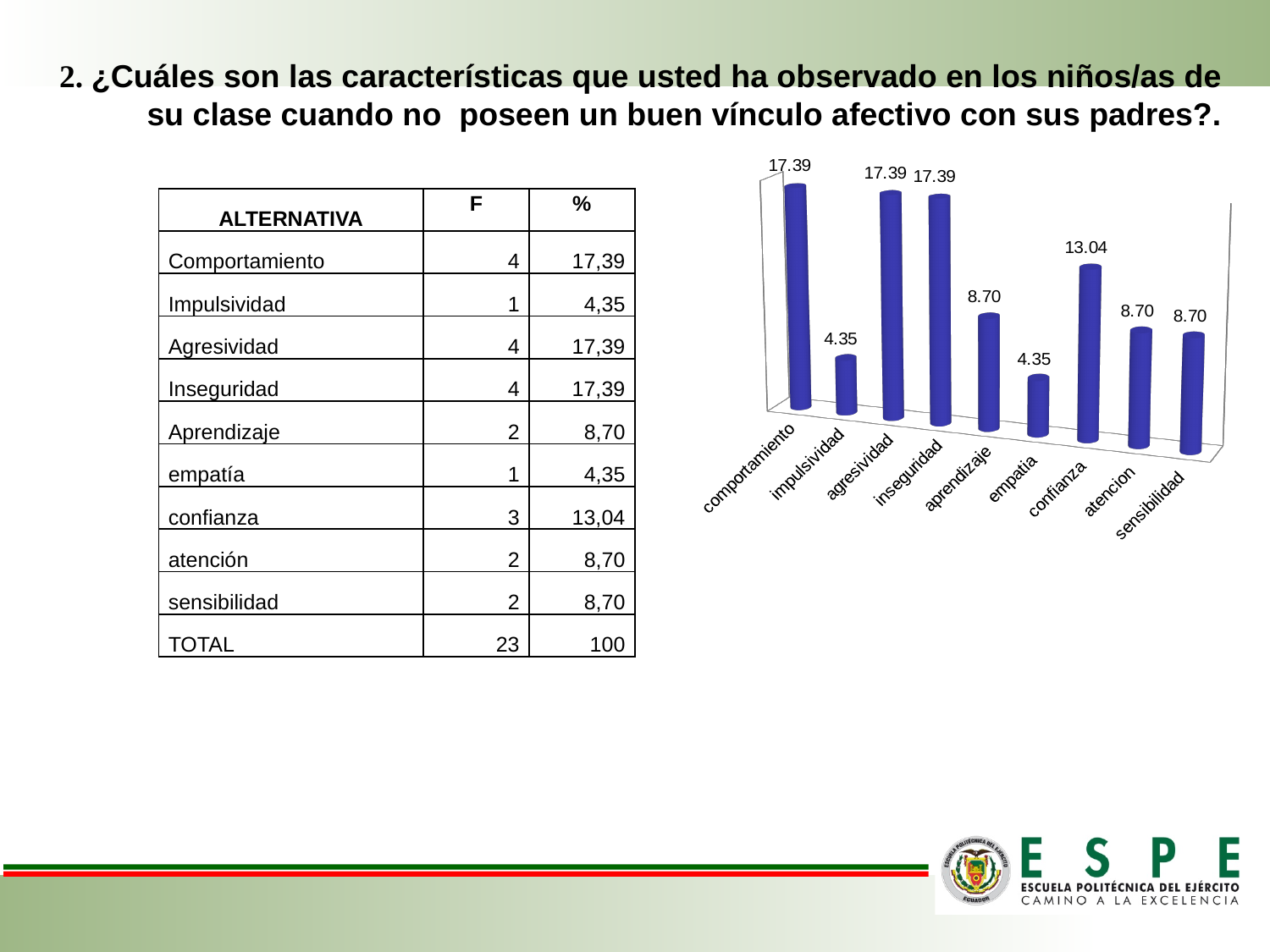
What value is shown for aprendizaje in the chart? 8.70 Which is larger in the chart, the value for empatia or the value for inseguridad? inseguridad What is the highest value labelled on any bar in the chart? 17.39 What kind of chart is shown on the slide? bar chart What is the lowest value labelled on any bar in the chart? 4.35 What value is shown for impulsividad in the chart? 4.35 What value is shown for confianza in the chart? 13.04 What value is shown for comportamiento in the chart? 17.39 Which is larger in the chart, the value for confianza or the value for atencion? confianza How many categories are plotted in the chart? 9 What value is shown for sensibilidad in the chart? 8.70 What is the difference between the values for agresividad and confianza in the chart? 4.35